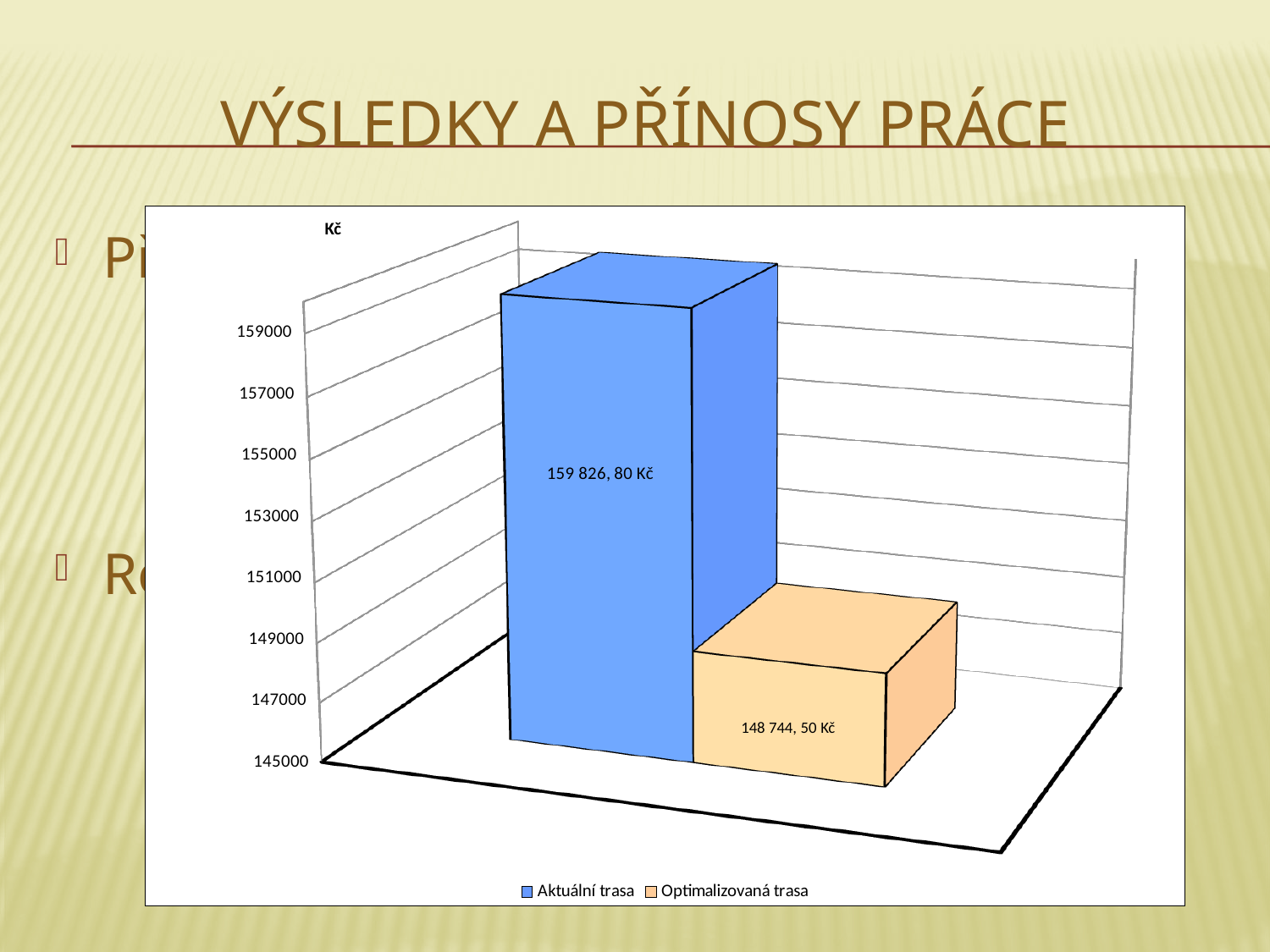
What unit label is shown at the top of the vertical axis? Kč What kind of chart is shown on the slide? Bar chart Which series has the lowest value on the chart? Optimalizovaná trasa How many series does the legend list? 2 Is the value for Aktuální trasa greater or less than 157000? greater Which series has the highest value on the chart? Aktuální trasa How many bars are plotted on the chart? 2 Is the value for Optimalizovaná trasa greater or less than 151000? less What is the value shown for Aktuální trasa? 159 826, 80 Kč What is the value shown for Optimalizovaná trasa? 148 744, 50 Kč What is the difference between the value for Aktuální trasa and the value for Optimalizovaná trasa? 11 082, 30 Kč Which series has the higher value, Aktuální trasa or Optimalizovaná trasa? Aktuální trasa